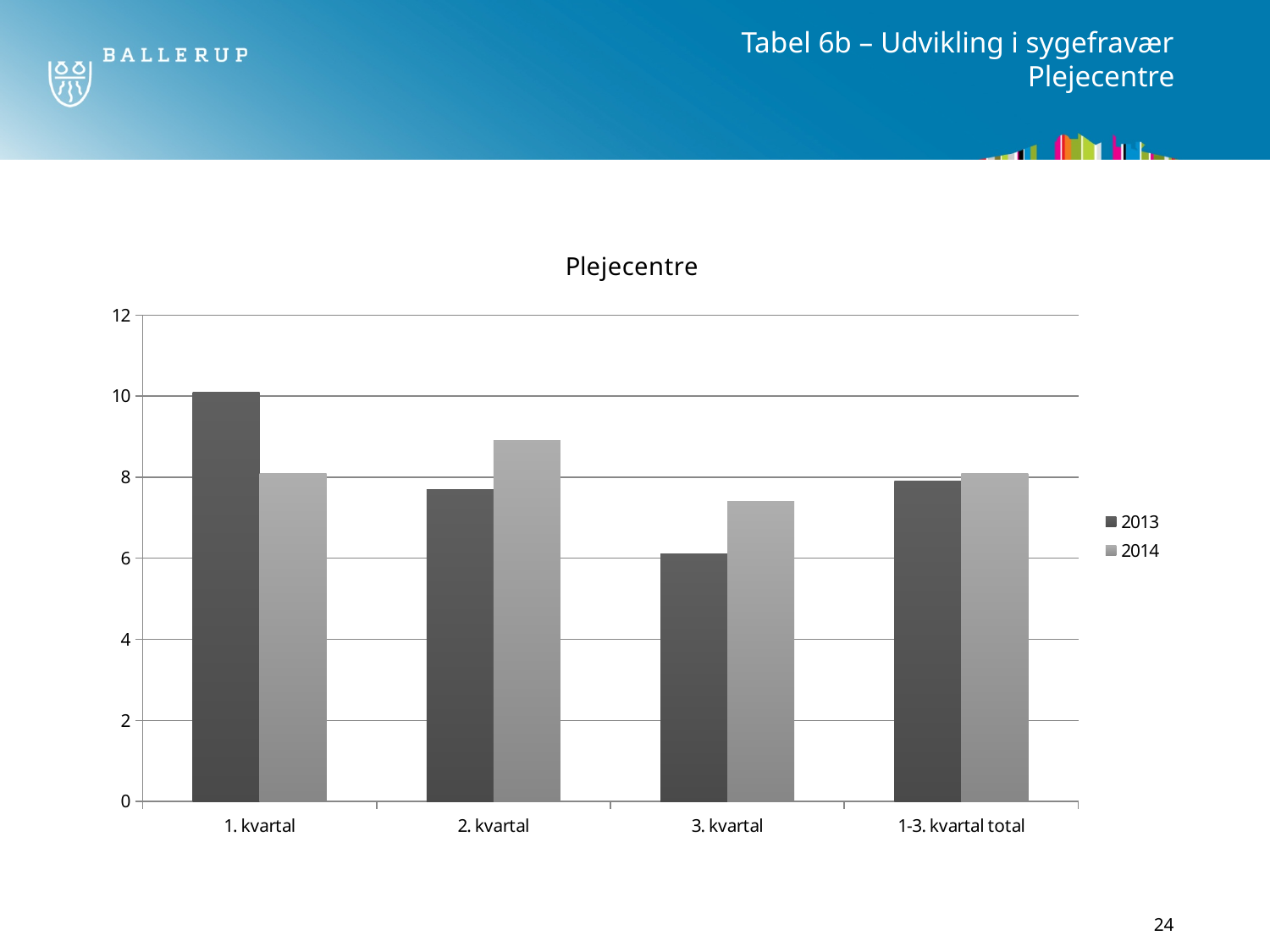
What is the title of the chart? Plejecentre Which category has the lowest value for 2013? 3. kvartal For 1. kvartal, which series has the larger value, 2013 or 2014? 2013 Is the value for 2013 in 3. kvartal greater or less than 8? less Which category has the lowest value for 2014? 3. kvartal For 2. kvartal, which series has the larger value, 2013 or 2014? 2014 Which category has the highest value for 2014? 2. kvartal What kind of chart is shown on the slide? bar chart Which category has the highest value for 2013? 1. kvartal How many series does the legend list? 2 How many categories are shown on the x axis? 4 Is the value for 2014 in 2. kvartal greater or less than 8? greater